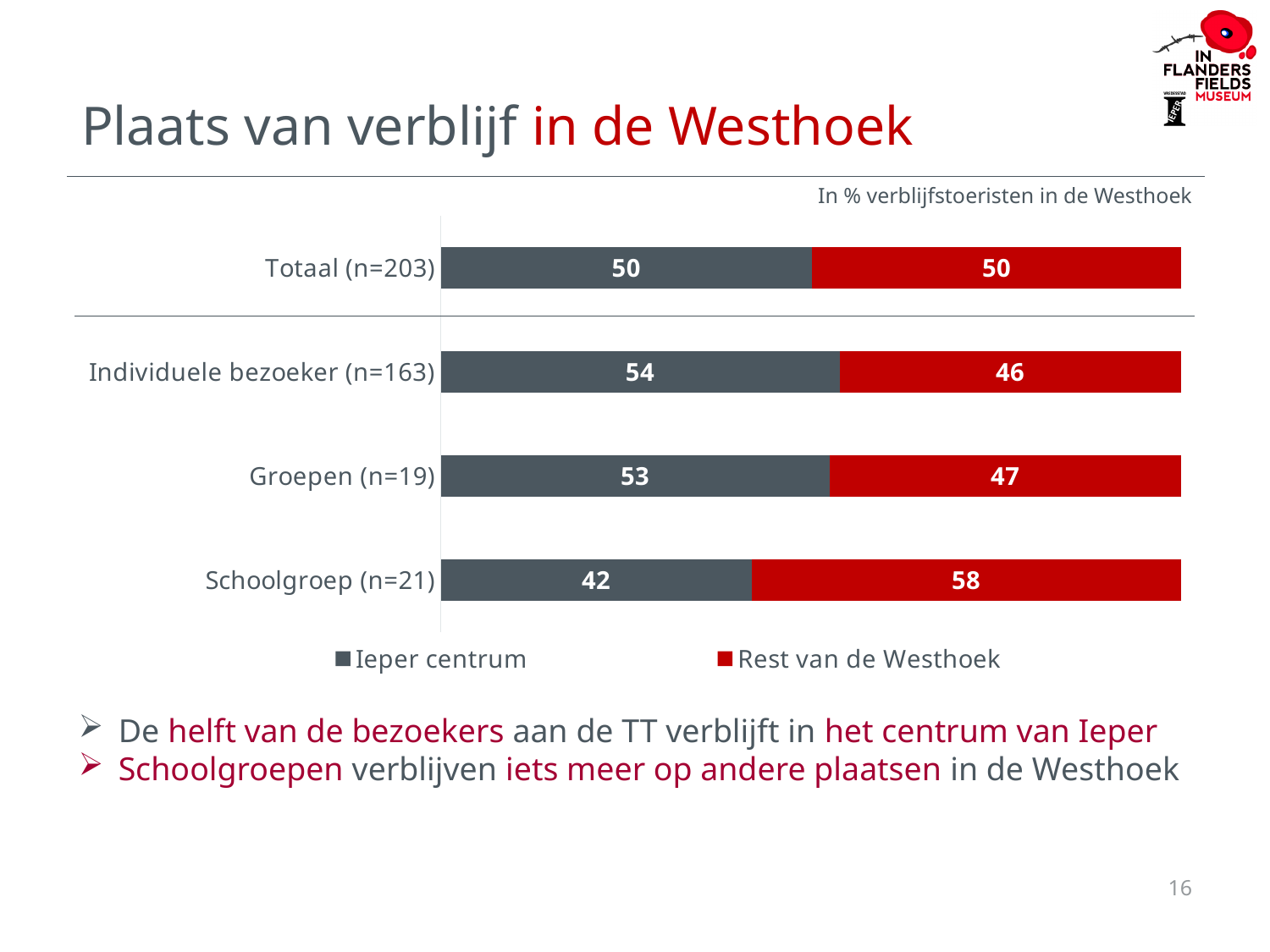
What is the value for Rest van de Westhoek for Groepen (n=19)? 47 For Groepen (n=19), which is larger: Ieper centrum or Rest van de Westhoek? Ieper centrum What is the value for Rest van de Westhoek for Schoolgroep (n=21)? 58 What is the total of the stacked bar for Schoolgroep (n=21)? 100 How many categories are shown on the chart? 4 Which category has the highest value for Ieper centrum? Individuele bezoeker (n=163) What is the value for Ieper centrum for Totaal (n=203)? 50 What kind of chart is shown on the slide? Stacked bar chart What is the difference between the Rest van de Westhoek value for Schoolgroep (n=21) and for Individuele bezoeker (n=163)? 12 What is the value for Ieper centrum for Individuele bezoeker (n=163)? 54 Which category has the lowest value for Ieper centrum? Schoolgroep (n=21) How many series does the legend list? 2